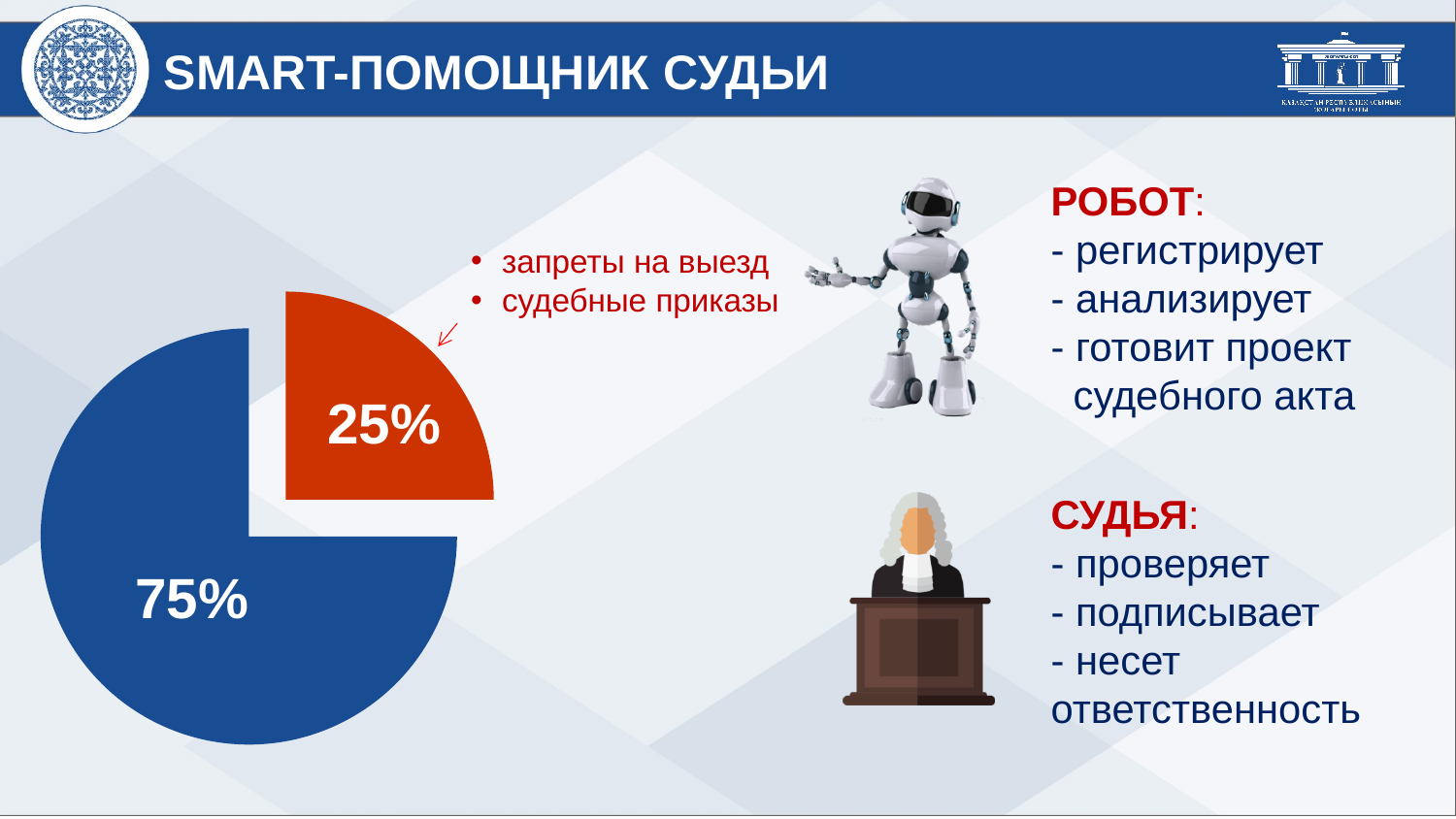
How many slices does the pie chart have? 2 Which slice of the pie chart is the smallest? the red slice (25%) What share of the pie does the blue slice represent? 75% What is the difference between the two slices of the pie chart? 50% Which is larger, the blue slice or the red slice? the blue slice What kind of chart is shown on the slide? pie chart What is the total of the two slices shown in the pie chart? 100% Which slice of the pie chart is the largest? the blue slice (75%) What colour is the 25% slice of the pie chart? red What share of the pie does the red (exploded) slice represent? 25% Which two items are listed next to the 25% slice of the pie chart? запреты на выезд; судебные приказы